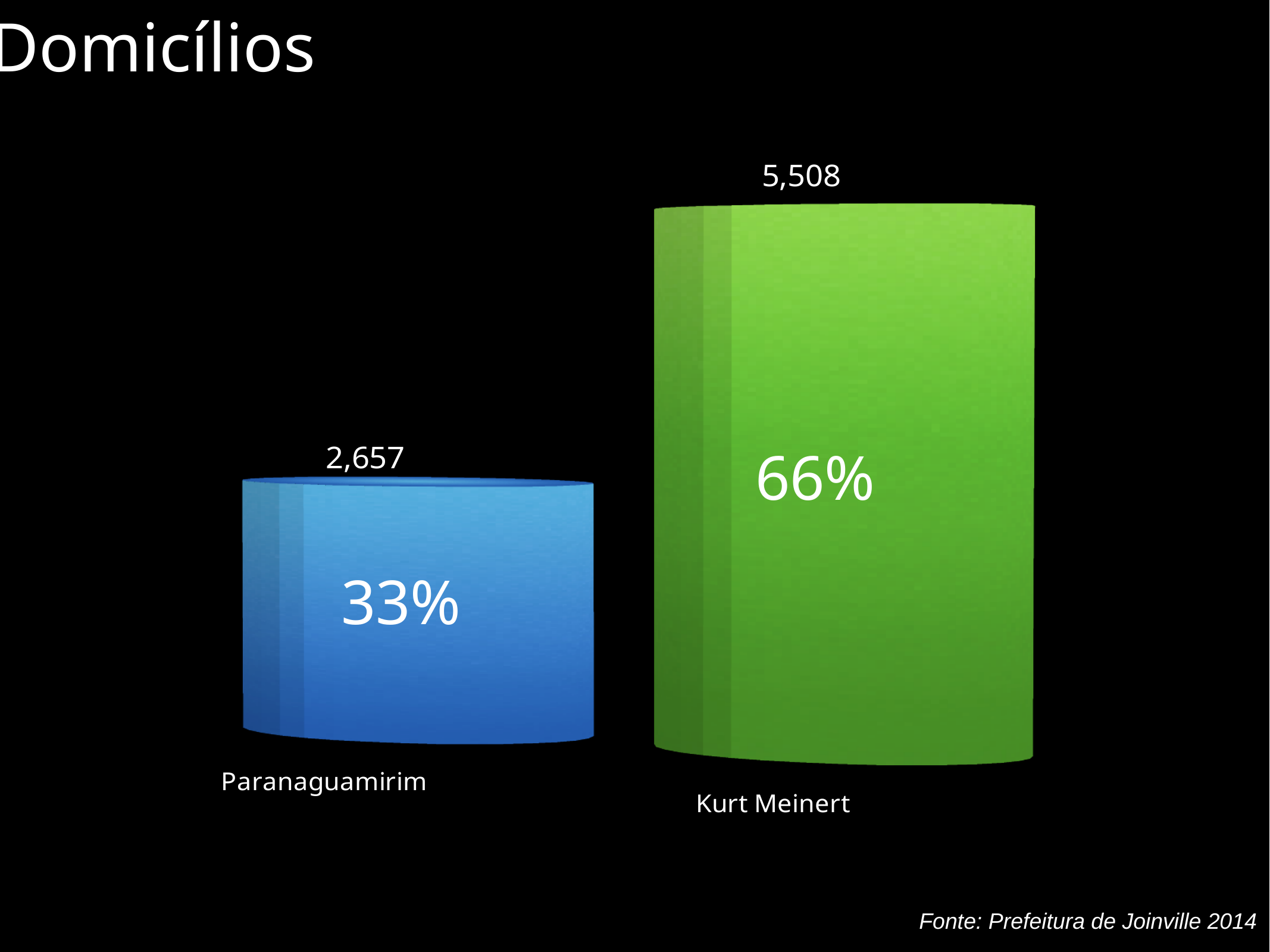
What is the value for Paranaguamirim? 2,657 Which category has the highest value? Kurt Meinert What is the value for Kurt Meinert? 5,508 How many categories are shown in the chart? 2 What kind of chart is shown on the slide? Bar chart Which category has the lowest value? Paranaguamirim What is the difference between the values for Kurt Meinert and Paranaguamirim? 2,851 What percentage is shown on the Kurt Meinert bar? 66% What colour is the bar for Kurt Meinert? Green Which is larger, the value for Paranaguamirim or the value for Kurt Meinert? Kurt Meinert What percentage is shown on the Paranaguamirim bar? 33% What is the title of the chart? Domicílios